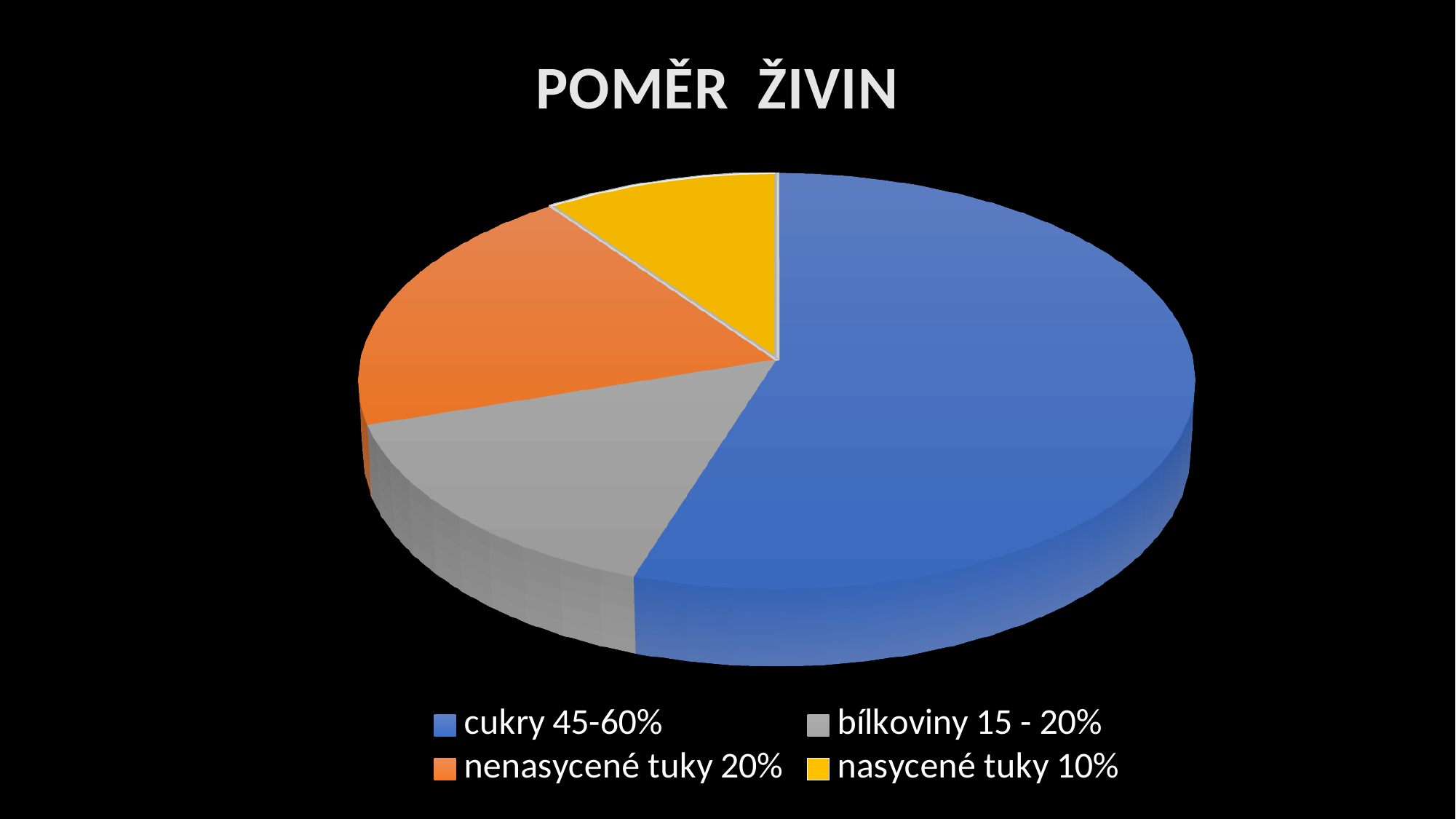
According to the legend, what share is given for nasycené tuky? 10% Which slice is larger, nenasycené tuky or nasycené tuky? nenasycené tuky Which category has the smallest slice of the pie? nasycené tuky 10% Which slice is larger, bílkoviny or nasycené tuky? bílkoviny Which slice is larger, cukry or nasycené tuky? cukry What kind of chart is shown on the slide? pie chart According to the legend, what range is given for cukry? 45-60% What is the title of the chart? POMĚR ŽIVIN Which category has the largest slice of the pie? cukry 45-60% What colour is the slice for bílkoviny? grey According to the legend, what share is given for nenasycené tuky? 20% How many slices does the pie chart have? 4